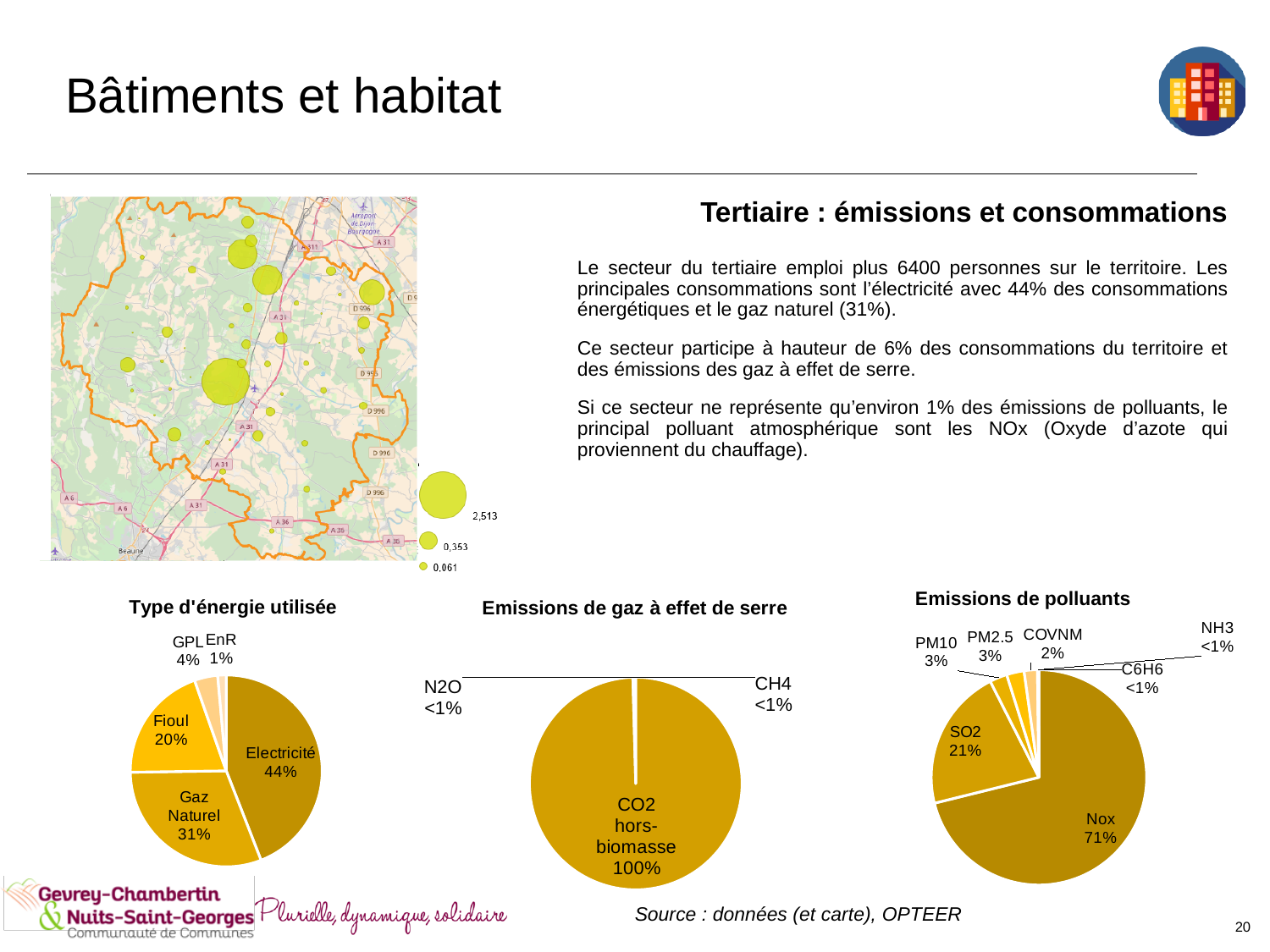
In the 'Type d'énergie utilisée' chart, which energy type has the smallest share? EnR In the 'Emissions de polluants' chart, what share does SO2 have? 21% What kind of chart is 'Emissions de gaz à effet de serre'? Pie chart In the 'Emissions de polluants' chart, which is larger, SO2 or PM10? SO2 In the 'Type d'énergie utilisée' chart, which energy type has the largest share? Electricité In the 'Emissions de polluants' chart, what share does Nox have? 71% In the 'Type d'énergie utilisée' chart, what share does Gaz Naturel have? 31% In the 'Emissions de gaz à effet de serre' chart, what share does CO2 hors-biomasse have? 100% In the 'Emissions de polluants' chart, how many pollutants are labelled? 7 In the 'Type d'énergie utilisée' chart, what is the difference in percentage points between Electricité and Fioul? 24 In the 'Type d'énergie utilisée' chart, what share does Electricité have? 44% In the 'Type d'énergie utilisée' chart, how many energy types are shown? 5